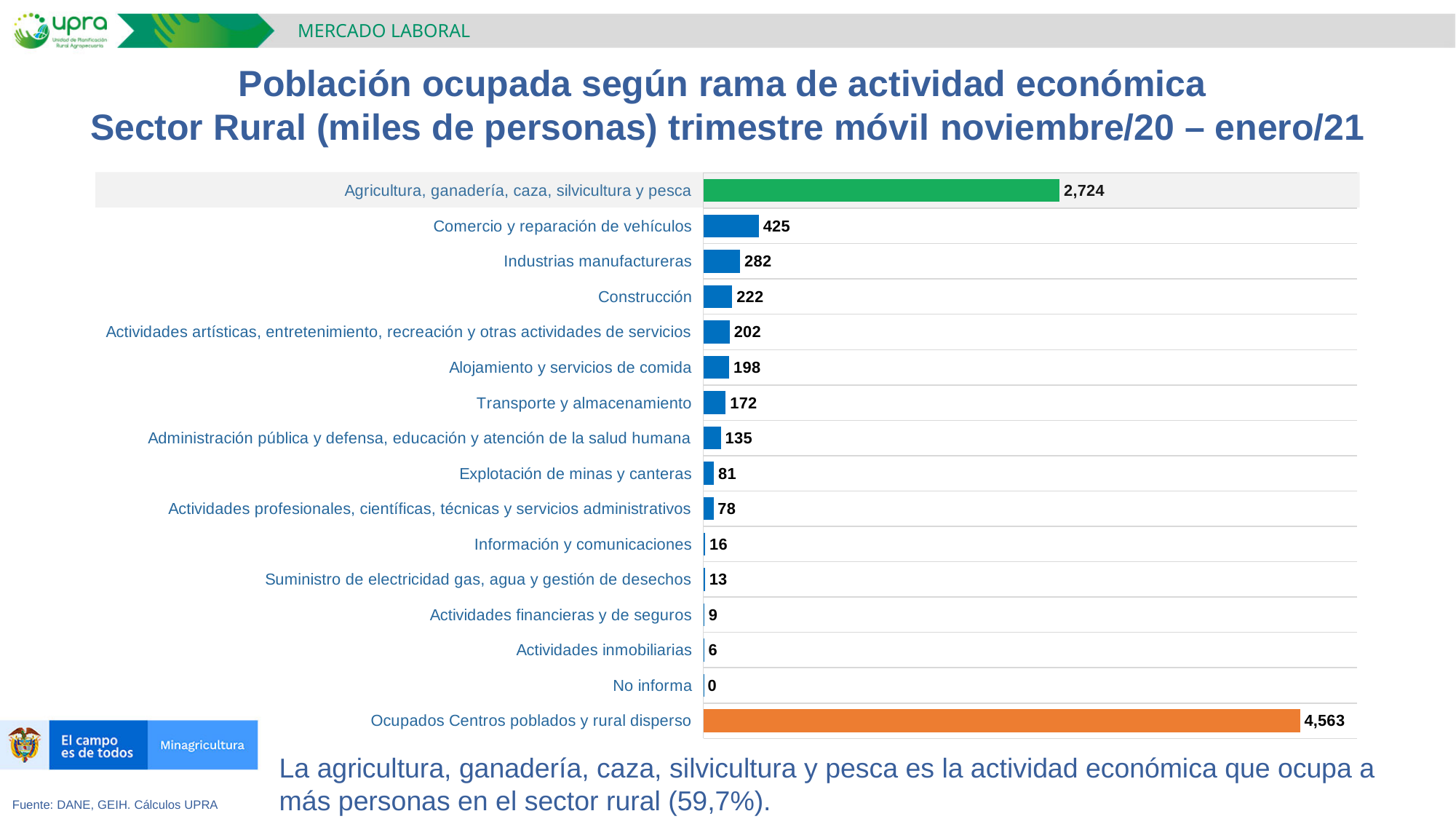
What is the difference between the values for Industrias manufactureras and Construcción? 60 Which is larger, the value for Explotación de minas y canteras or the value for Actividades profesionales, científicas, técnicas y servicios administrativos? Explotación de minas y canteras What is the value for Comercio y reparación de vehículos? 425 What colour is the bar for Ocupados Centros poblados y rural disperso? Orange How many bars are shown on the chart? 16 What is the value for Ocupados Centros poblados y rural disperso? 4,563 Which bar has the highest value on the chart? Ocupados Centros poblados y rural disperso Which category has the lowest value on the chart? No informa What is the value for Agricultura, ganadería, caza, silvicultura y pesca? 2,724 What is the difference between the values for Agricultura, ganadería, caza, silvicultura y pesca and Comercio y reparación de vehículos? 2,299 What kind of chart is shown on the slide? Bar chart What is the value for Transporte y almacenamiento? 172